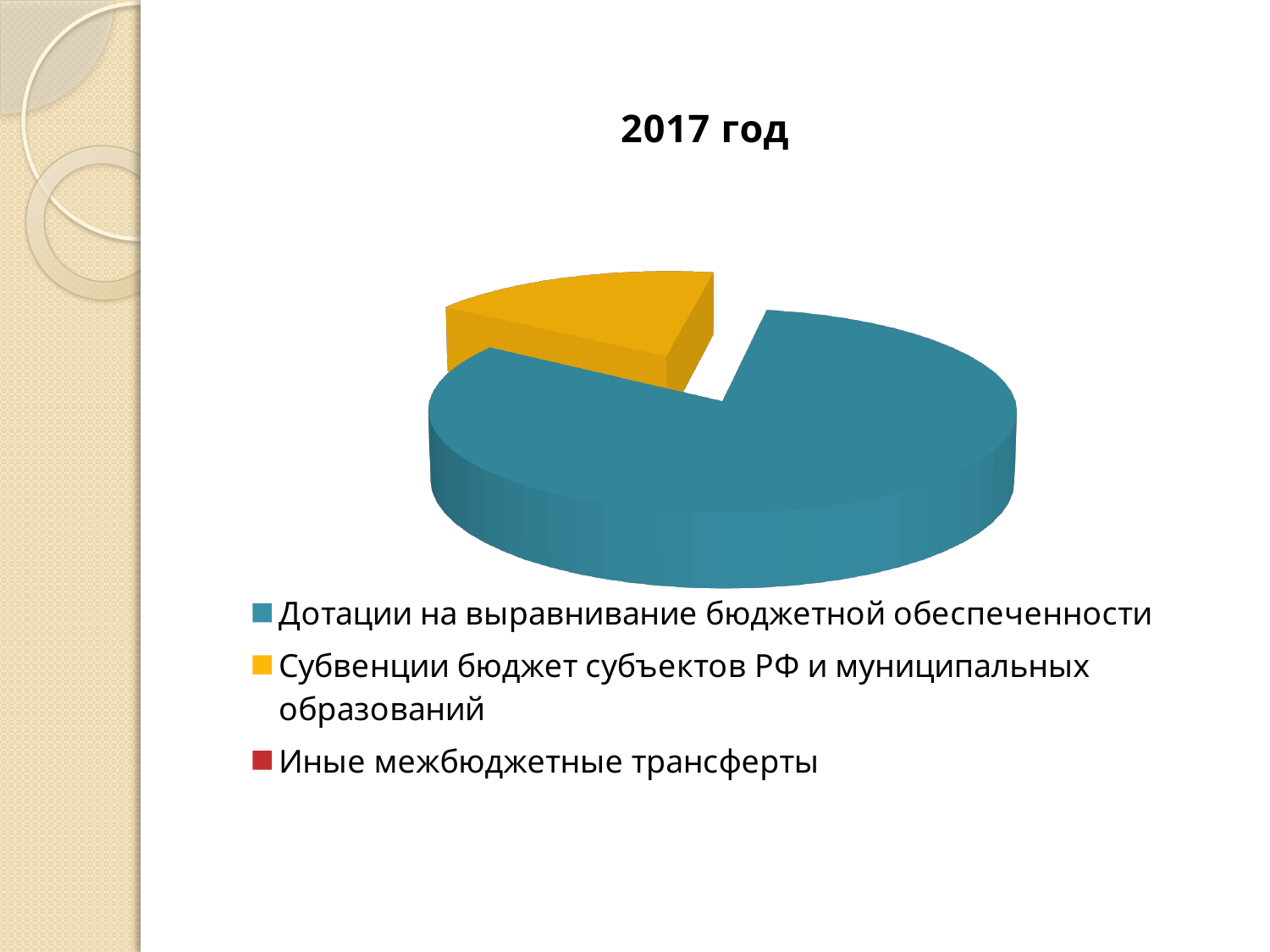
Which colour represents Субвенции бюджет субъектов РФ и муниципальных образований in the chart? yellow Does the slice for Дотации на выравнивание бюджетной обеспеченности take up more or less than half of the pie? more How many categories does the legend of the chart list? 3 What is the title of the chart? 2017 год Which is larger: the slice for Дотации на выравнивание бюджетной обеспеченности or the slice for Субвенции бюджет субъектов РФ и муниципальных образований? Дотации на выравнивание бюджетной обеспеченности Which category has the largest slice of the pie? Дотации на выравнивание бюджетной обеспеченности What kind of chart is shown on the slide? pie chart